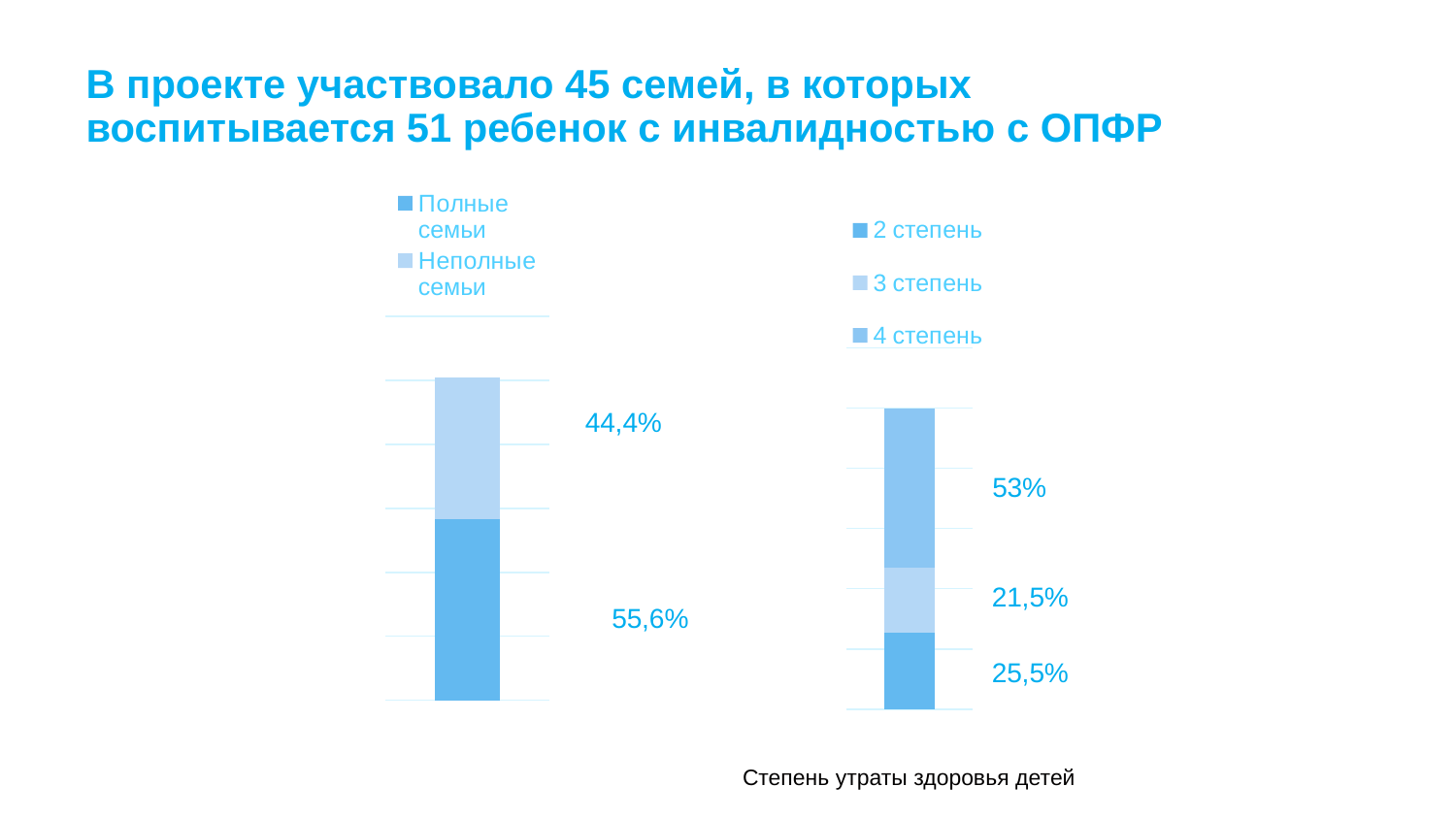
What kind of chart is the left chart? Stacked bar chart In the right chart (Степень утраты здоровья детей), what is the value for 2 степень? 25,5% In the right chart (Степень утраты здоровья детей), which category has the largest share? 4 степень In the right chart (Степень утраты здоровья детей), which category has the smallest share? 3 степень In the right chart (Степень утраты здоровья детей), what is the value for 4 степень? 53% How many series does the legend of the right chart (Степень утраты здоровья детей) list? 3 In the left chart, what is the value for Полные семьи? 55,6% In the left chart, what is the value for Неполные семьи? 44,4% In the right chart (Степень утраты здоровья детей), what is the difference between 4 степень and 2 степень? 27,5% In the left chart, which is larger: Полные семьи or Неполные семьи? Полные семьи In the right chart (Степень утраты здоровья детей), what is the value for 3 степень? 21,5% In the left chart, what is the difference between Полные семьи and Неполные семьи? 11,2%